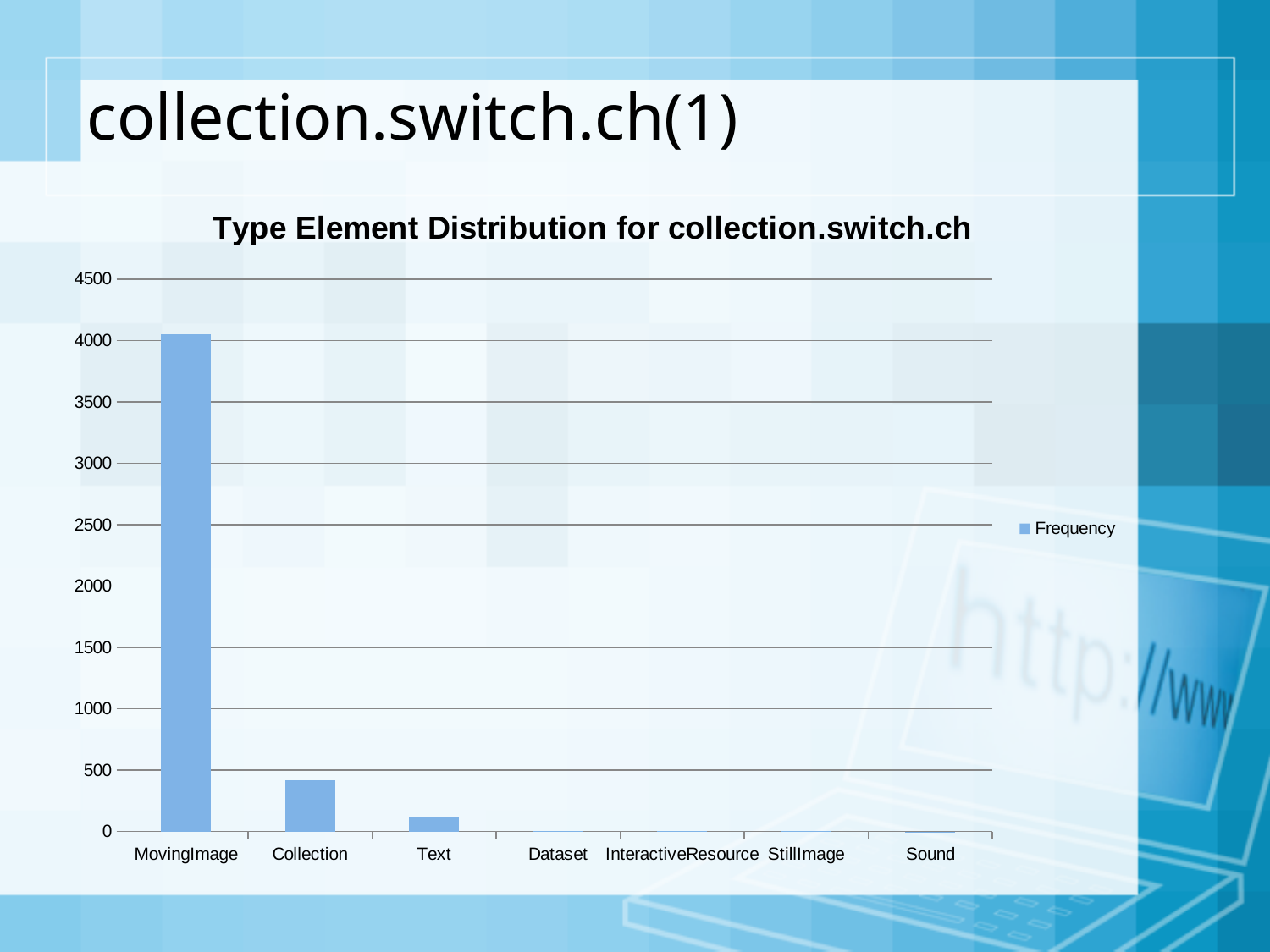
How many categories are shown on the x axis of the chart? 7 Is the frequency for MovingImage greater or less than 3500? greater What kind of chart is shown on the slide? bar chart Is the frequency for Collection greater or less than 500? less How many series does the chart's legend list? 1 Which has a higher frequency, Collection or Text? Collection Do the frequencies generally rise or fall moving from left to right along the x axis? fall Which category has the highest frequency? MovingImage Is the frequency for Text greater or less than 500? less What is the title of the chart? Type Element Distribution for collection.switch.ch What is the name of the series shown in the legend? Frequency Which has a higher frequency, MovingImage or Collection? MovingImage